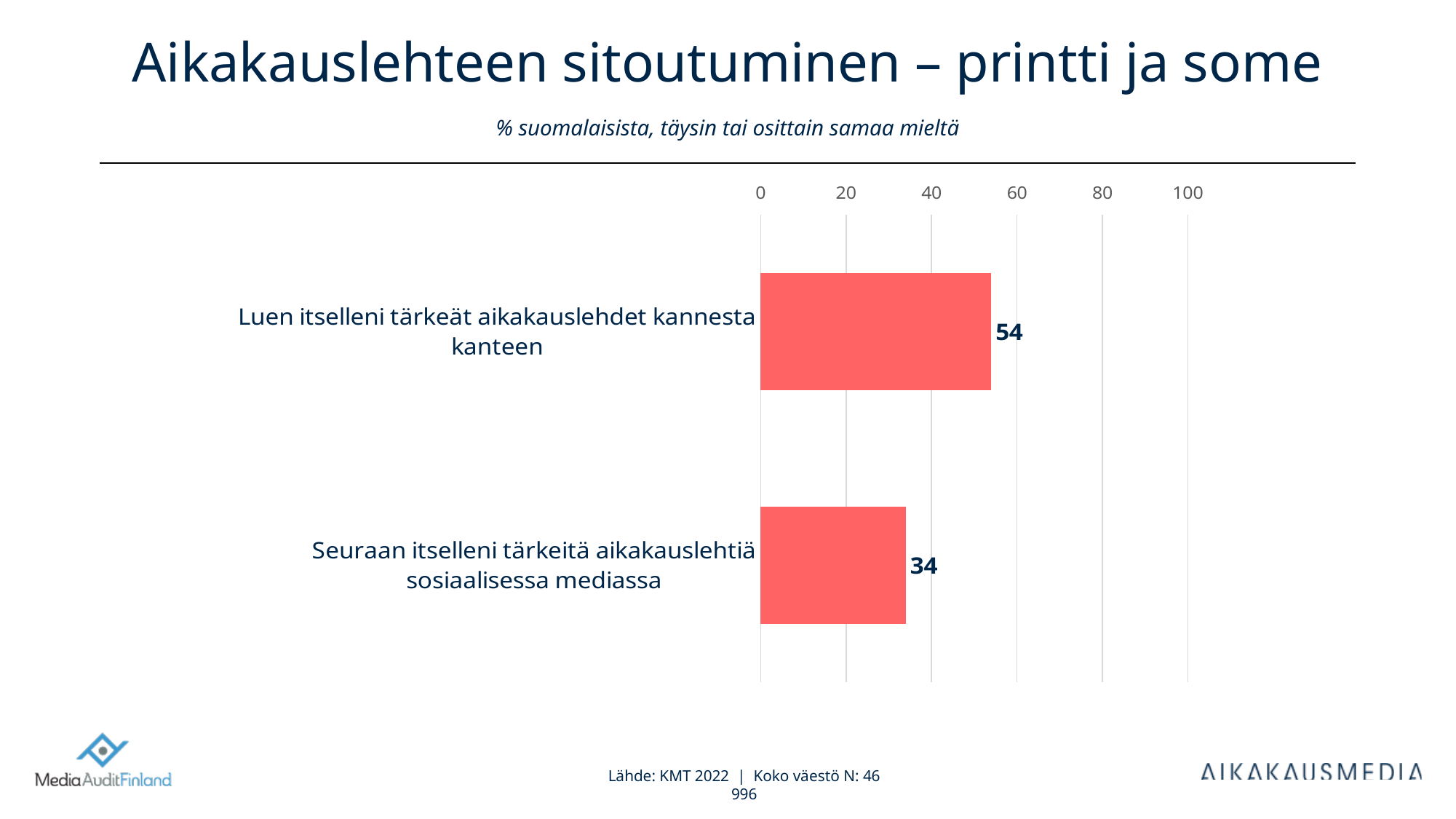
How many categories are shown in the chart? 2 What is the highest value shown on the chart's axis? 100 What kind of chart is shown on the slide? Bar chart Which is larger: the value for "Luen itselleni tärkeät aikakauslehdet kannesta kanteen" or for "Seuraan itselleni tärkeitä aikakauslehtiä sosiaalisessa mediassa"? Luen itselleni tärkeät aikakauslehdet kannesta kanteen What is the value for "Luen itselleni tärkeät aikakauslehdet kannesta kanteen"? 54 What is the difference between the values for reading magazines cover to cover and following magazines on social media? 20 What is the value for "Seuraan itselleni tärkeitä aikakauslehtiä sosiaalisessa mediassa"? 34 What is the title of the slide? Aikakauslehteen sitoutuminen – printti ja some Which category has the highest value? Luen itselleni tärkeät aikakauslehdet kannesta kanteen Is the value for "Luen itselleni tärkeät aikakauslehdet kannesta kanteen" greater or less than 60? less Is the value for "Seuraan itselleni tärkeitä aikakauslehtiä sosiaalisessa mediassa" greater or less than 40? less Which category has the lowest value? Seuraan itselleni tärkeitä aikakauslehtiä sosiaalisessa mediassa